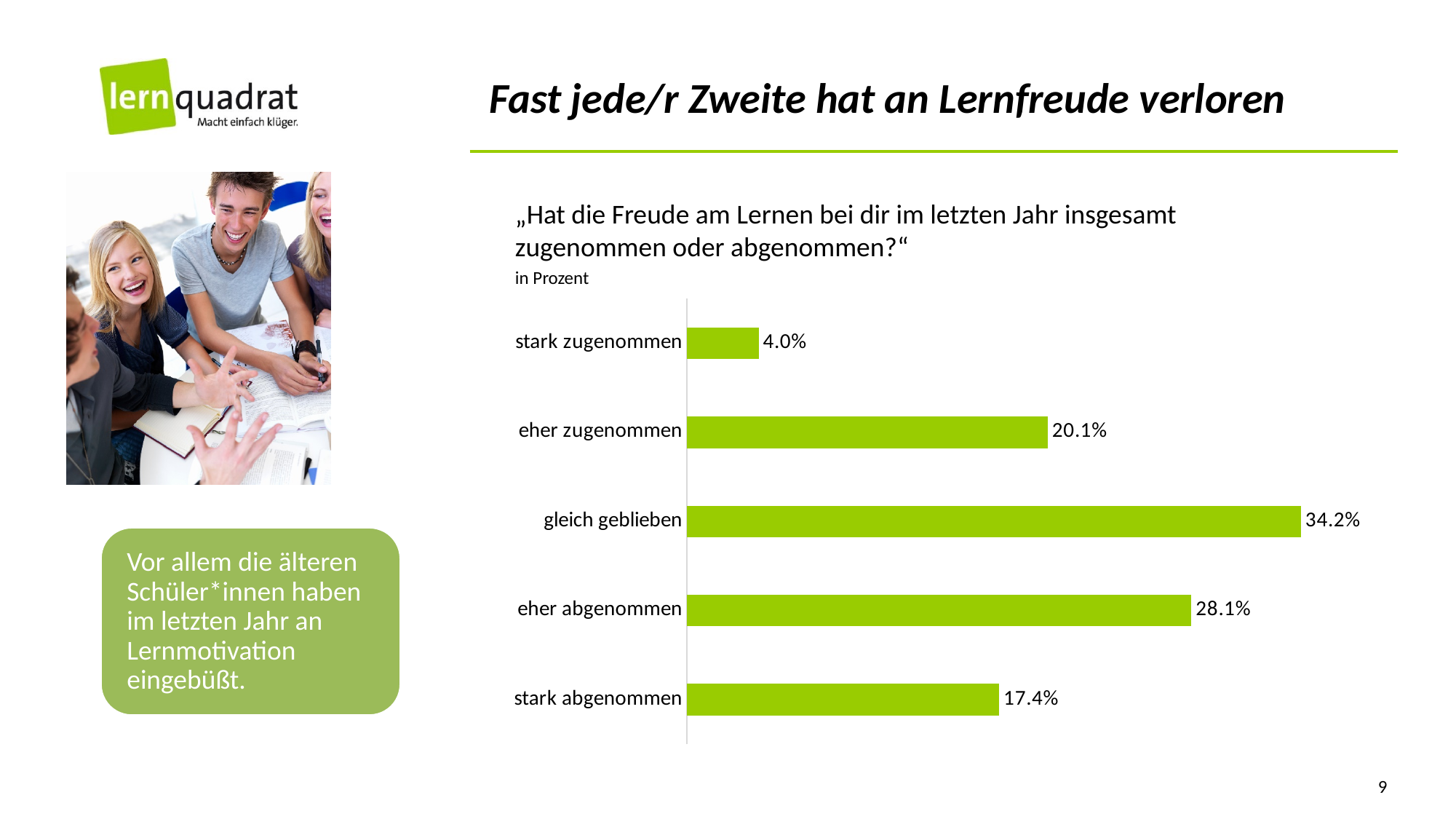
What is the difference between "eher abgenommen" and "eher zugenommen"? 8.0% How many categories are shown in the chart? 5 What is the difference between "gleich geblieben" and "stark abgenommen"? 16.8% What is the value for "stark zugenommen"? 4.0% What unit are the chart values given in, according to the note under the question? in Prozent Which is larger, "eher abgenommen" or "stark abgenommen"? eher abgenommen What kind of chart is shown on the slide? bar chart Which category has the lowest value? stark zugenommen What is the value for "stark abgenommen"? 17.4% What is the value for "gleich geblieben"? 34.2% Which category has the highest value? gleich geblieben What is the value for "eher zugenommen"? 20.1%